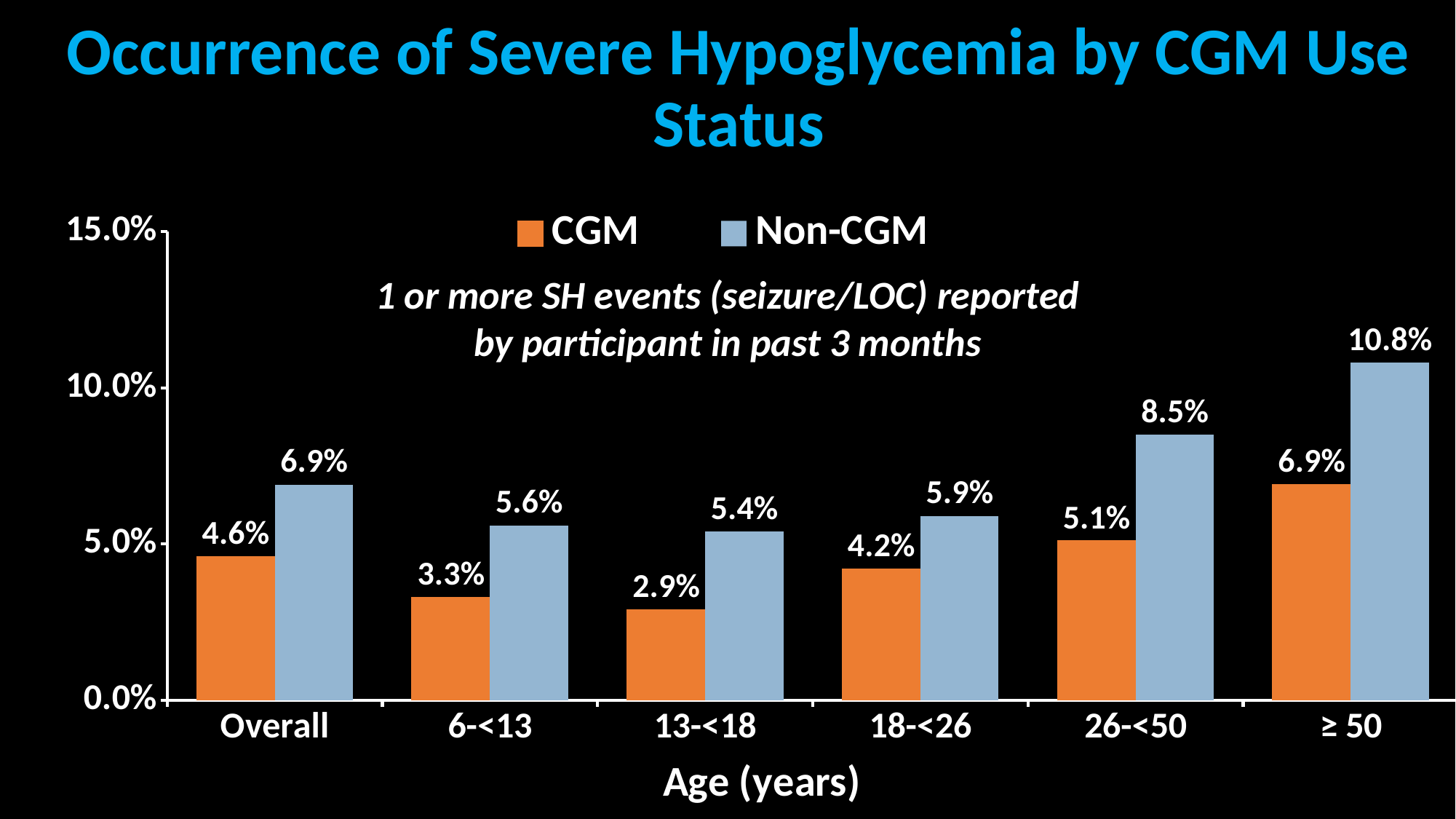
Which category has the lowest CGM value? 13-<18 What is the Non-CGM value for the ≥ 50 age group? 10.8% How many age categories are shown on the x axis? 6 How many series does the legend list? 2 What is the label of the x axis? Age (years) What kind of chart is shown on the slide? Bar chart Which is larger for the 18-<26 age group, the CGM value or the Non-CGM value? Non-CGM What is the CGM value for the 13-<18 age group? 2.9% Which age category has the highest Non-CGM value? ≥ 50 What is the CGM value for the Overall category? 4.6% What is the difference between the Non-CGM and CGM values for the 26-<50 age group? 3.4% Is the Non-CGM value for the ≥ 50 age group greater or less than 10.0%? greater